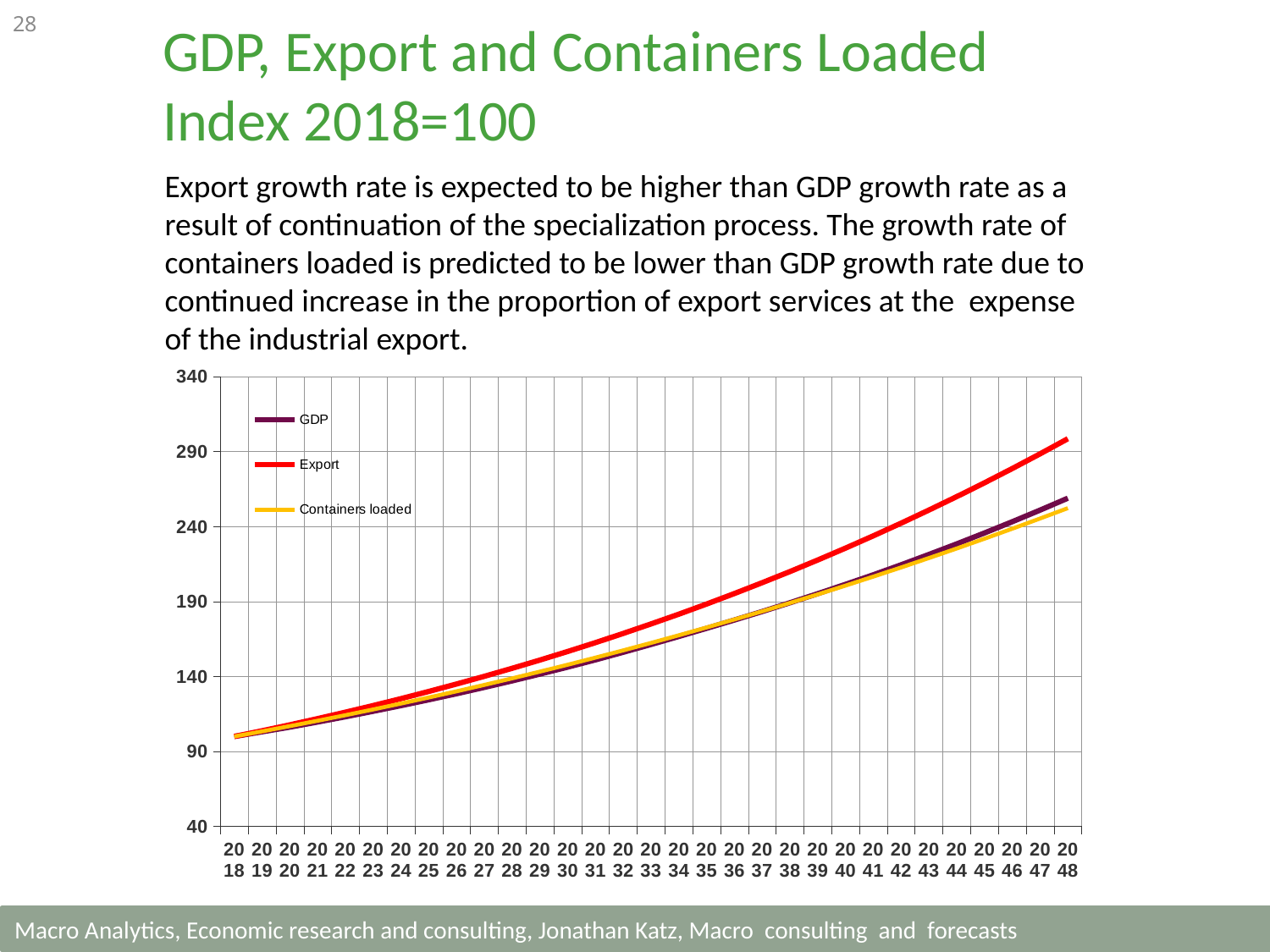
Which is larger in 2048, the value for Export or the value for GDP? Export Is the value for GDP in 2018 greater or less than 140? less What kind of chart is shown on the slide? line chart Is the value for Export in 2048 greater or less than 240? greater How many series does the legend list? 3 Which series has the highest value in 2048? Export Is the value for Export in 2038 greater or less than 190? greater What colour is the Export line in the chart? red Do the values of the Export series rise or fall from 2018 to 2048? rise How many years are plotted along the x axis? 31 Which is larger in 2040, the value for Export or the value for Containers loaded? Export Which series are listed in the legend? GDP, Export, Containers loaded